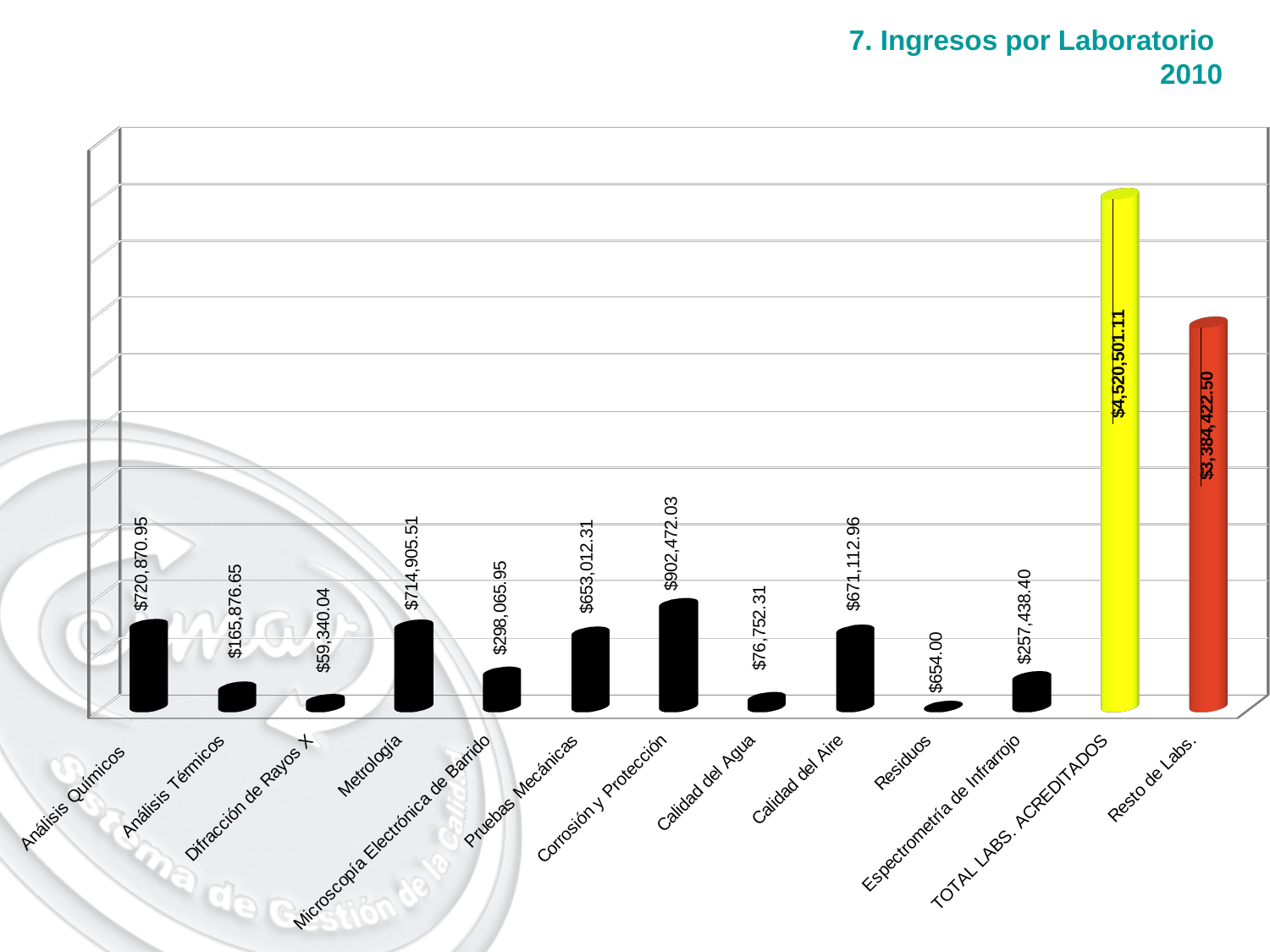
What is the difference between Corrosión y Protección and Calidad del Aire? $231,359.07 What is the value for Resto de Labs.? $3,384,422.50 Which category has the lowest value? Residuos What is the value for Espectrometría de Infrarrojo? $257,438.40 What is the difference between TOTAL LABS. ACREDITADOS and Resto de Labs.? $1,136,078.61 What is the value for TOTAL LABS. ACREDITADOS? $4,520,501.11 What kind of chart is shown on the slide? Bar chart Which is larger, Pruebas Mecánicas or Microscopía Electrónica de Barrido? Pruebas Mecánicas What is the value for Corrosión y Protección? $902,472.03 What is the value for Residuos? $654.00 How many categories are shown on the x axis? 13 Which category has the highest value? TOTAL LABS. ACREDITADOS